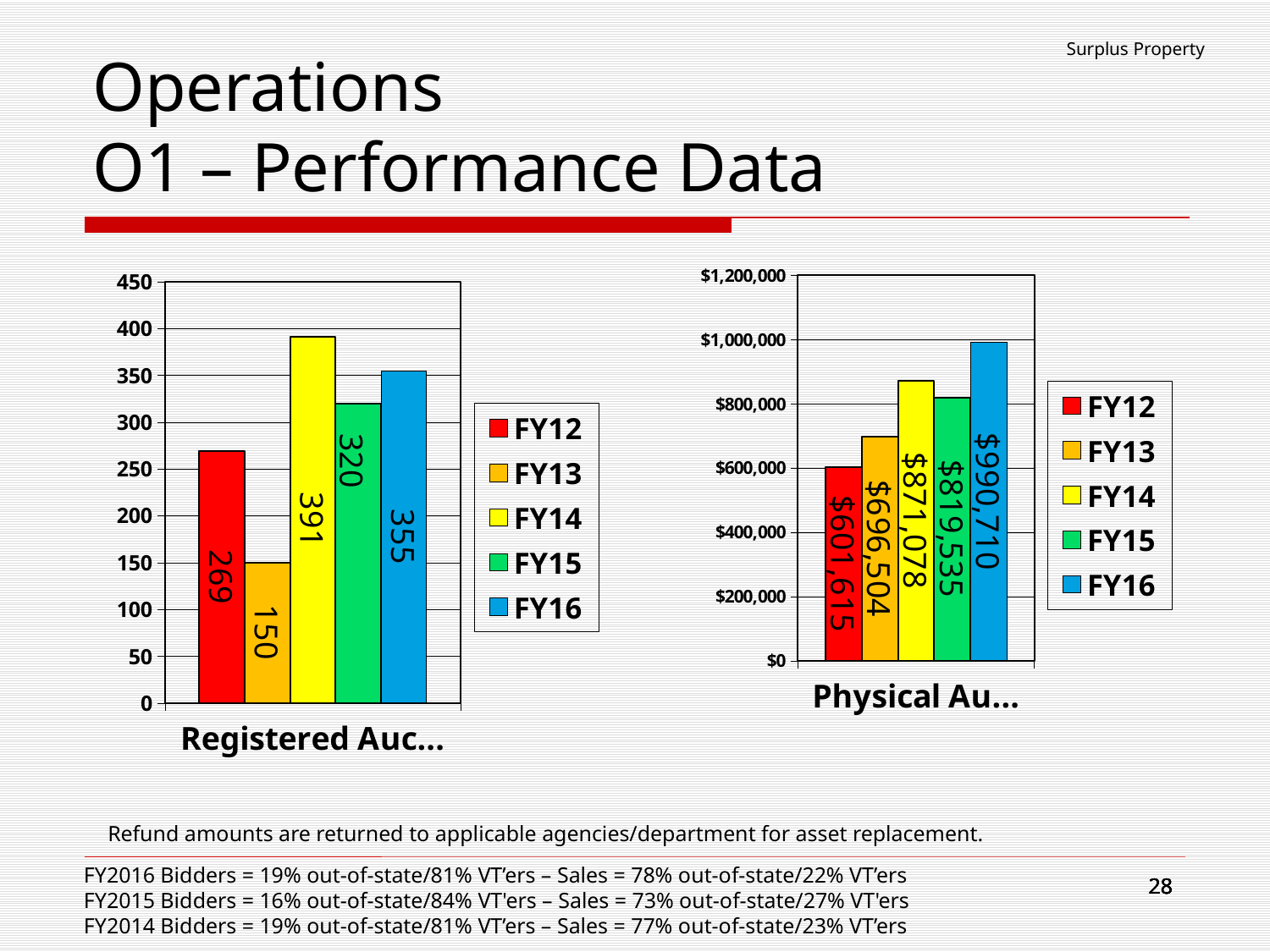
In the left chart, what is the difference between the FY16 and FY12 values? 86 In the left chart, which is larger, the value for FY15 or FY16? FY16 In the left chart, which fiscal year has the highest value? FY14 How many series does the legend of the right chart list? 5 In the right chart, what is the difference between the FY14 and FY15 values? $51,543 What type of chart is the left chart? Bar chart In the right chart, which fiscal year has the lowest value? FY12 In the left chart, what is the value for FY13? 150 In the left chart, what is the value for FY14? 391 In the right chart, what is the value for FY12? $601,615 In the left chart, which fiscal year has the lowest value? FY13 In the right chart, what is the value for FY16? $990,710